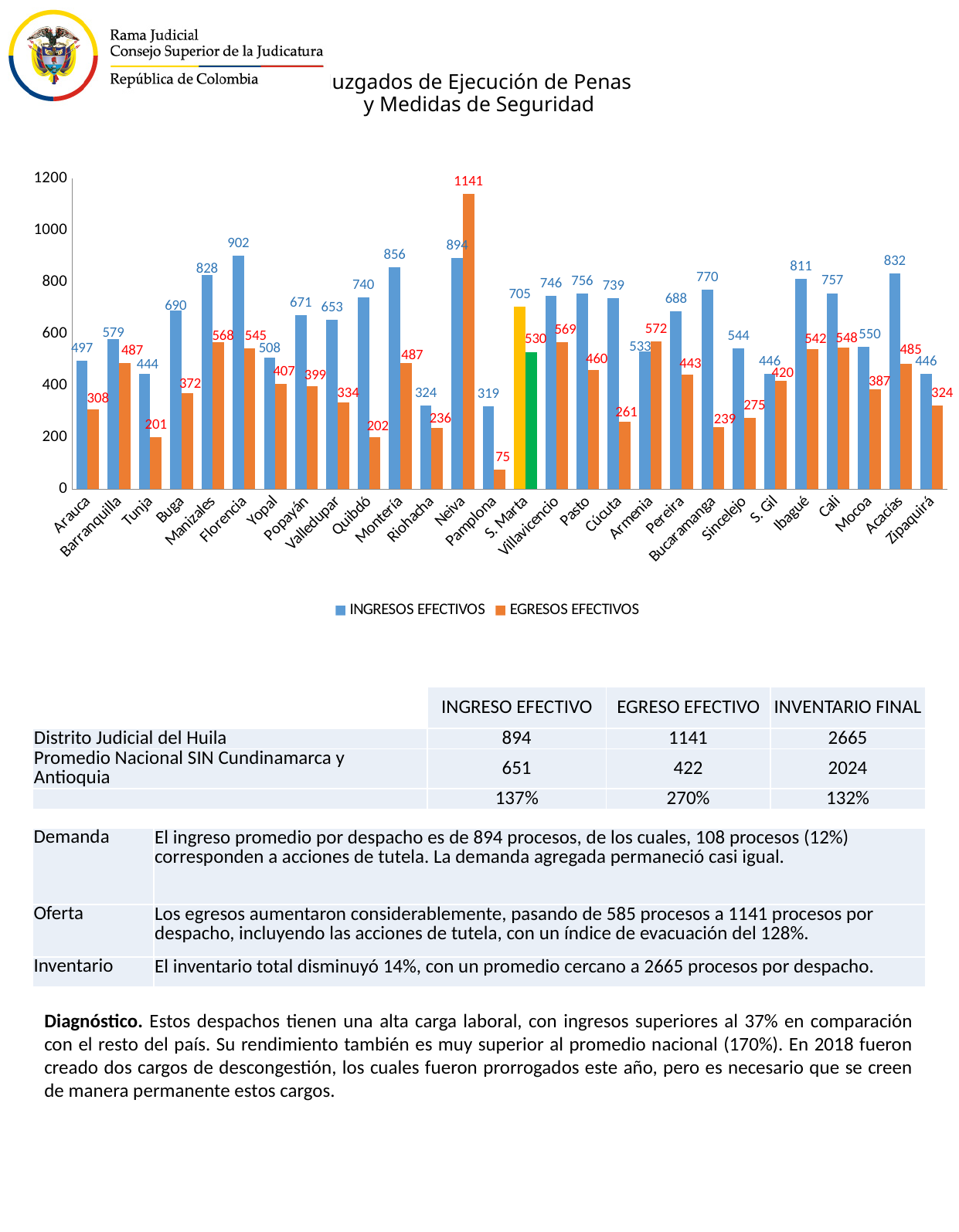
What is the EGRESOS EFECTIVOS value for Neiva? 1141 What type of chart is shown on the slide? bar chart Which is larger for Armenia, INGRESOS EFECTIVOS or EGRESOS EFECTIVOS? EGRESOS EFECTIVOS How many series does the chart legend list? 2 What is the INGRESOS EFECTIVOS value for Neiva? 894 Which category has the highest INGRESOS EFECTIVOS value? Florencia Which category has the lowest EGRESOS EFECTIVOS value? Pamplona What is the difference between INGRESOS EFECTIVOS and EGRESOS EFECTIVOS for Quibdó? 538 Which category has the highest EGRESOS EFECTIVOS value? Neiva What is the EGRESOS EFECTIVOS value for Pamplona? 75 How many categories are shown on the x axis of the chart? 28 What is the INGRESOS EFECTIVOS value for S. Marta? 705